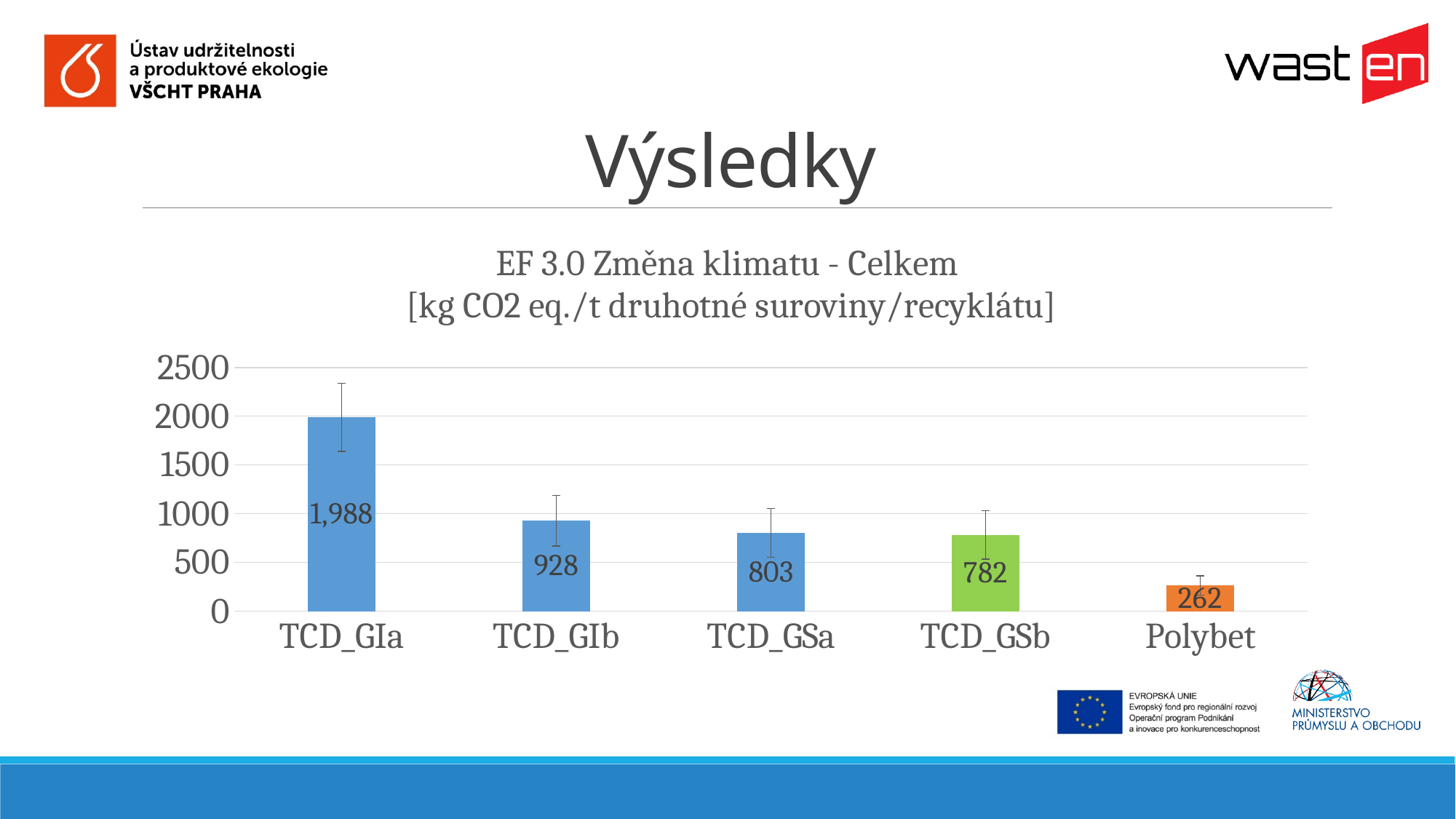
What is the value for Polybet? 262 What is the difference between the values for TCD_GSb and Polybet? 520 What is the value for TCD_GIa? 1,988 What is the difference between the values for TCD_GIa and TCD_GIb? 1,060 Which is larger, the value for TCD_GIb or the value for TCD_GSb? TCD_GIb Which category has the highest value? TCD_GIa How many categories are shown on the x axis? 5 What kind of chart is shown on the slide? Bar chart Which category has the lowest value? Polybet What is the title of the chart? EF 3.0 Změna klimatu - Celkem [kg CO2 eq./t druhotné suroviny/recyklátu] What is the value for TCD_GIb? 928 What is the value for TCD_GSa? 803